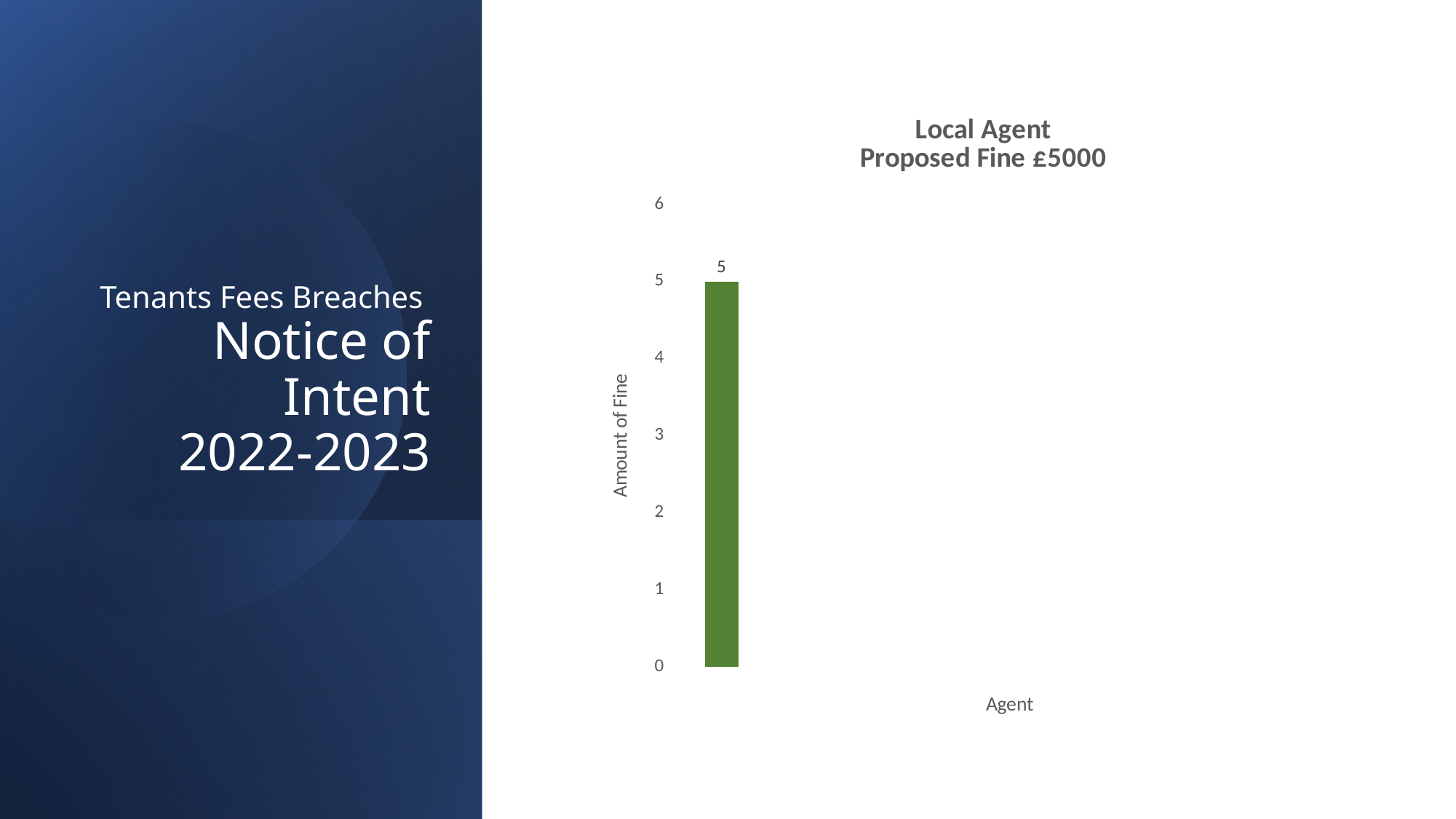
What kind of chart is shown on the slide? bar chart What is the label of the vertical axis? Amount of Fine How many bars are plotted in the chart? 1 What is the title of the chart? Local Agent Proposed Fine £5000 Is the value of the bar greater or less than 4? greater What value is shown by the data label on the bar? 5 What is the highest value shown on the vertical axis? 6 Is the value of the bar greater or less than 6? less